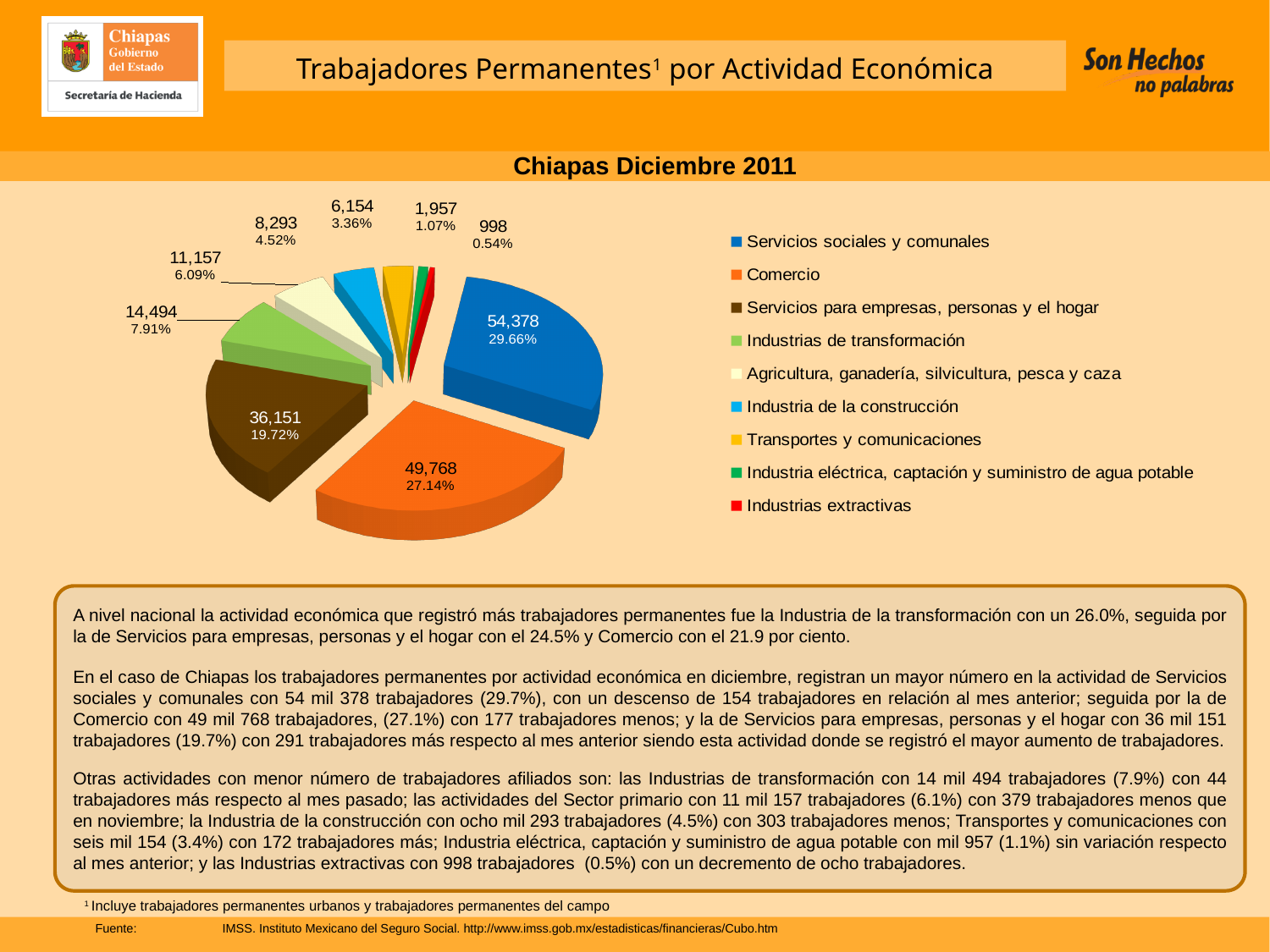
What is the value shown for Servicios sociales y comunales? 54,378 What is the value shown for Comercio? 49,768 What is the difference between the values for Servicios sociales y comunales and Comercio? 4,610 Which is larger, the value for Industria de la construcción or the value for Transportes y comunicaciones? Industria de la construcción How many categories does the legend of the pie chart list? 9 Which category has the largest slice of the pie? Servicios sociales y comunales What kind of chart is shown on the slide? Pie chart What is the title shown above the pie chart? Chiapas Diciembre 2011 Which category has the smallest slice of the pie? Industrias extractivas What percentage share does the Industrias de transformación slice show? 7.91% What percentage share does the Industrias extractivas slice show? 0.54% What is the value shown for Servicios para empresas, personas y el hogar? 36,151